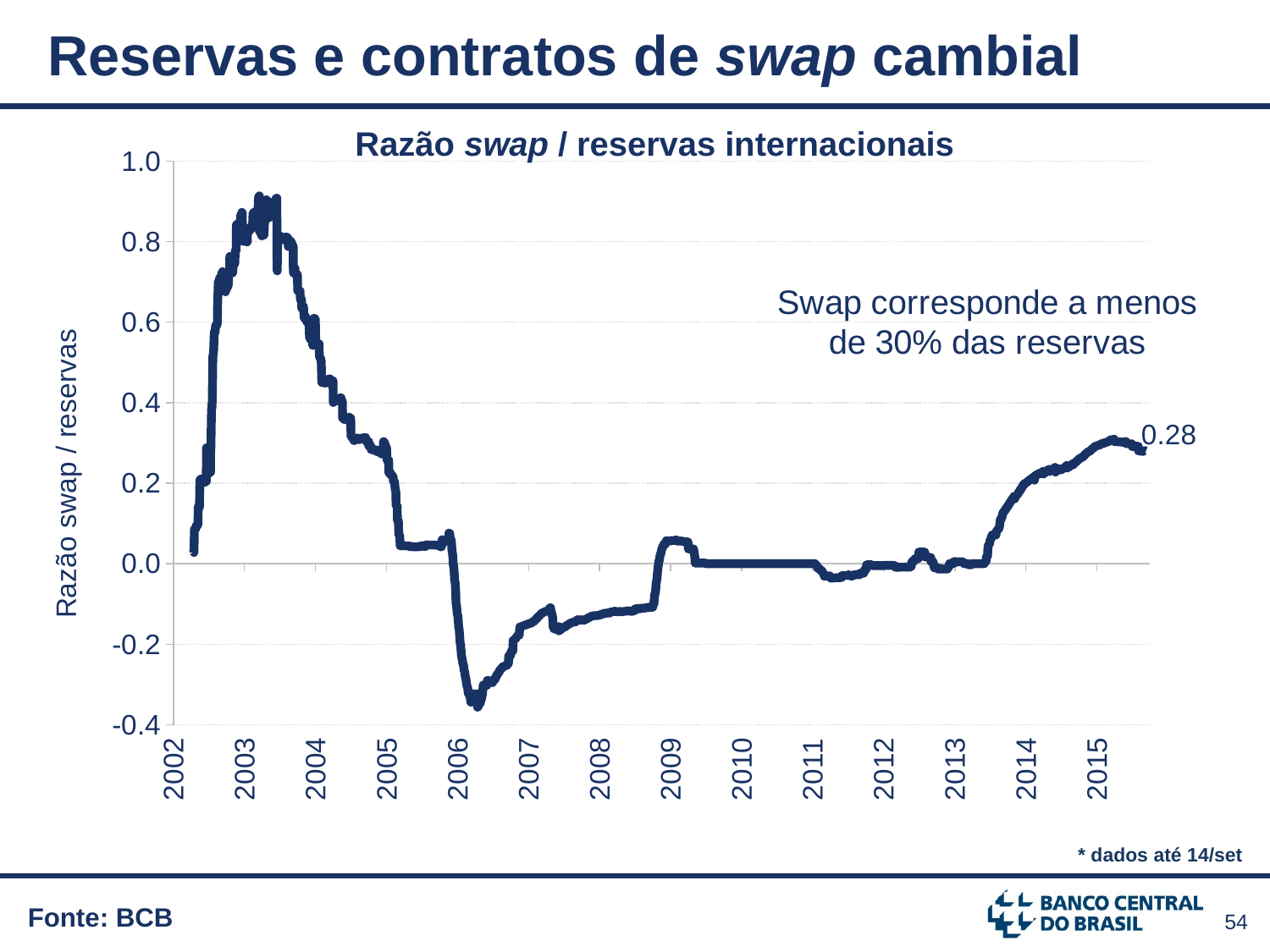
In which year does the swap/reserves ratio reach its lowest point? 2006 What is the latest value of the swap/reserves ratio labelled at the end of the line? 0.28 How many year labels are shown on the x axis? 14 What is the title of the chart? Razão swap / reservas internacionais Is the value of the ratio during 2010 greater or less than 0.2? less What is the label of the y axis? Razão swap / reservas Does the swap/reserves ratio rise or fall between 2003 and 2005? fall Does the swap/reserves ratio rise or fall between 2013 and 2015? rise Is the peak value of the ratio in 2003 greater or less than 0.8? greater In which year does the swap/reserves ratio reach its highest point? 2003 Is the lowest value of the ratio in 2006 greater or less than -0.2? less What kind of chart is shown on the slide? line chart